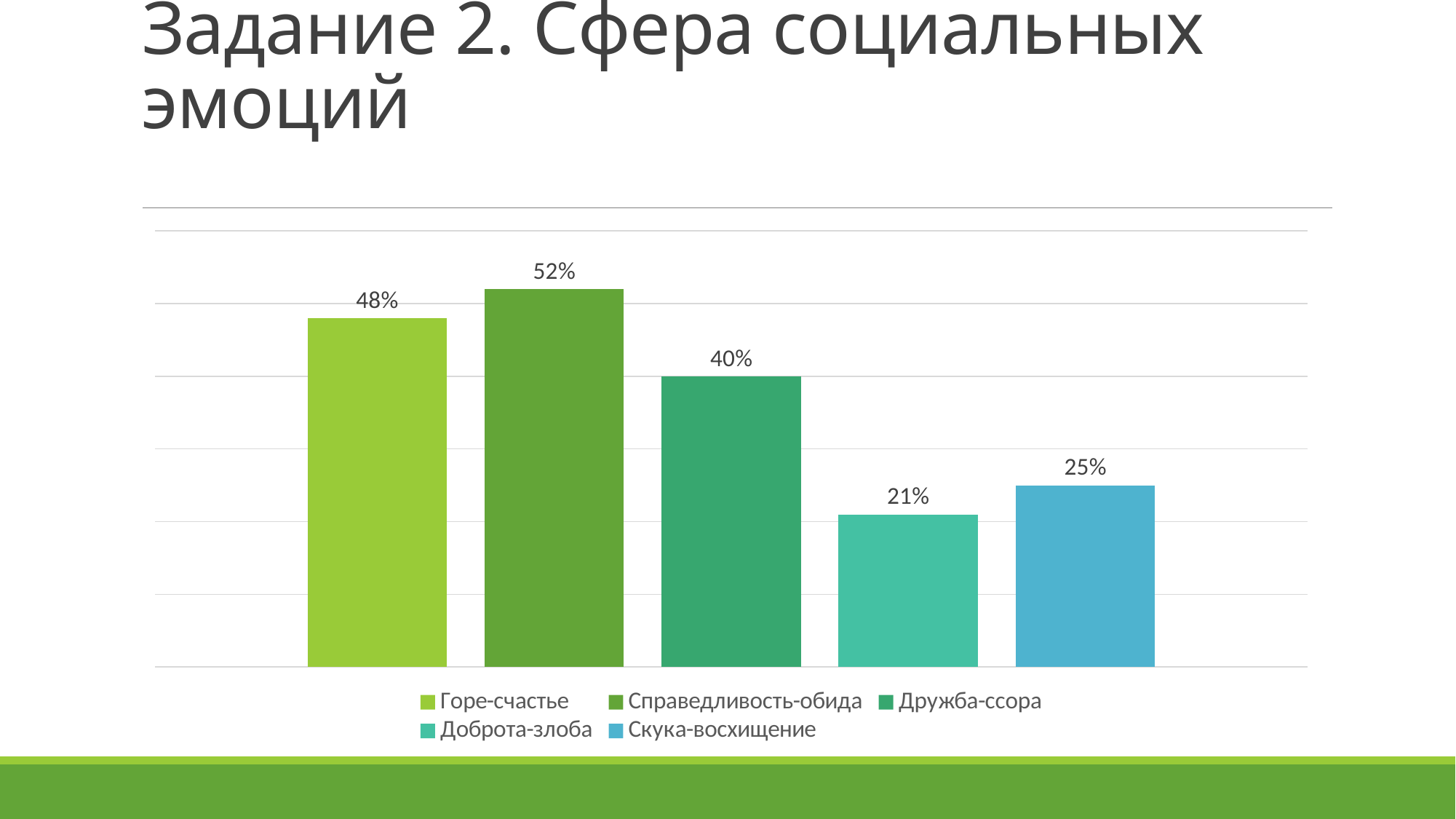
What is the value for Доброта-злоба? 21% Which category has the highest value? Справедливость-обида What is the value for Справедливость-обида? 52% What is the value for Горе-счастье? 48% How many entries does the legend list? 5 Which category has the lowest value? Доброта-злоба What is the value for Дружба-ссора? 40% How many bars are shown in the chart? 5 What is the value for Скука-восхищение? 25% What is the difference between the values for Справедливость-обида and Горе-счастье? 4% What kind of chart is shown on the slide? Bar chart Which is larger, the value for Дружба-ссора or the value for Скука-восхищение? Дружба-ссора